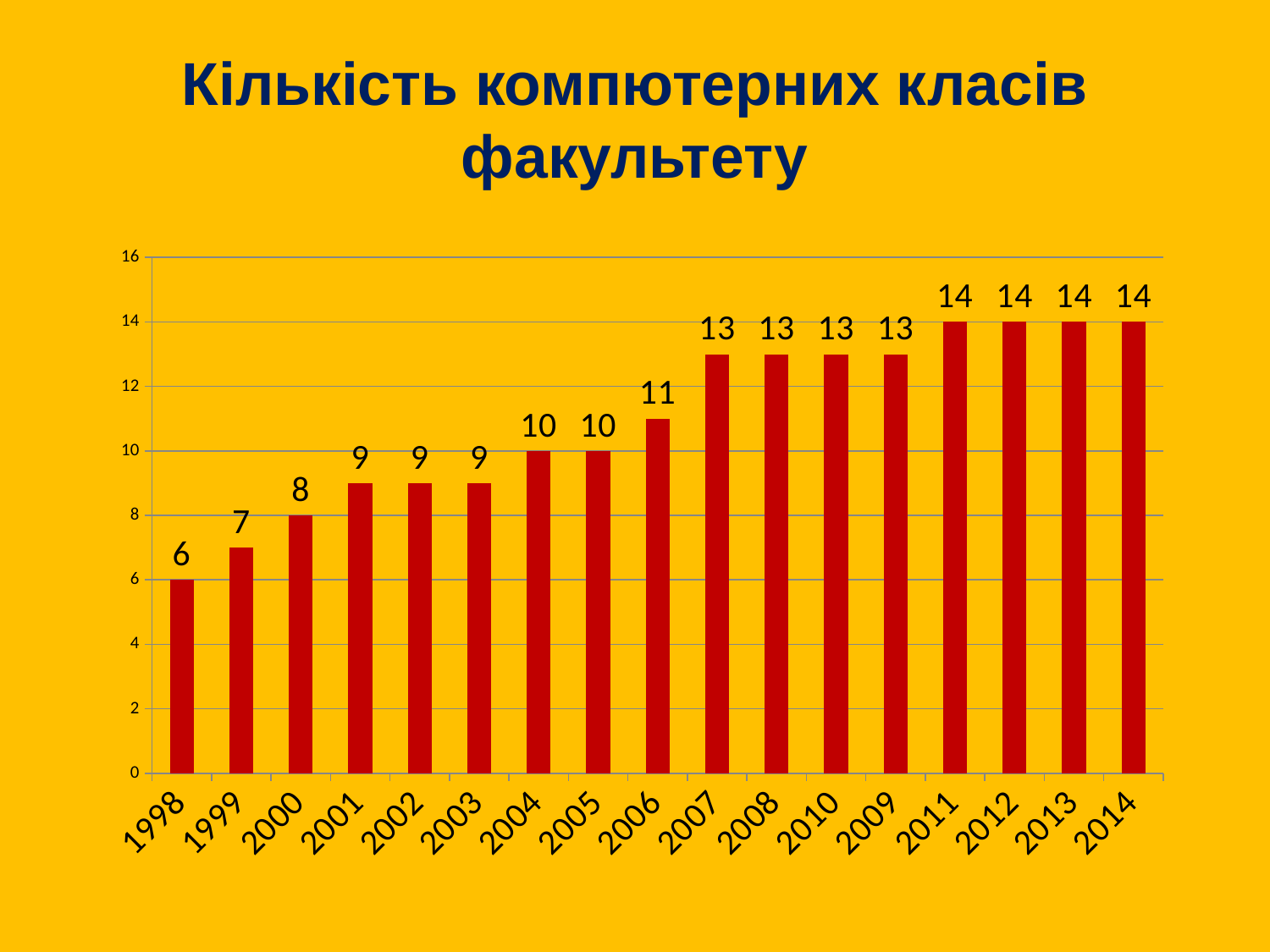
What is the title of the chart? Кількість компютерних класів факультету What is the value for 2006? 11 Which year has the lowest value? 1998 What is the difference between the values for 2007 and 2004? 3 What is the value for 2014? 14 How many years are shown on the x axis? 17 What kind of chart is shown on the slide? bar chart What is the value for 1998? 6 What is the value for 2000? 8 What is the difference between the values for 2014 and 1998? 8 Which is larger, the value for 2001 or the value for 2005? 2005 Do the values generally rise or fall from 1998 to 2014? rise